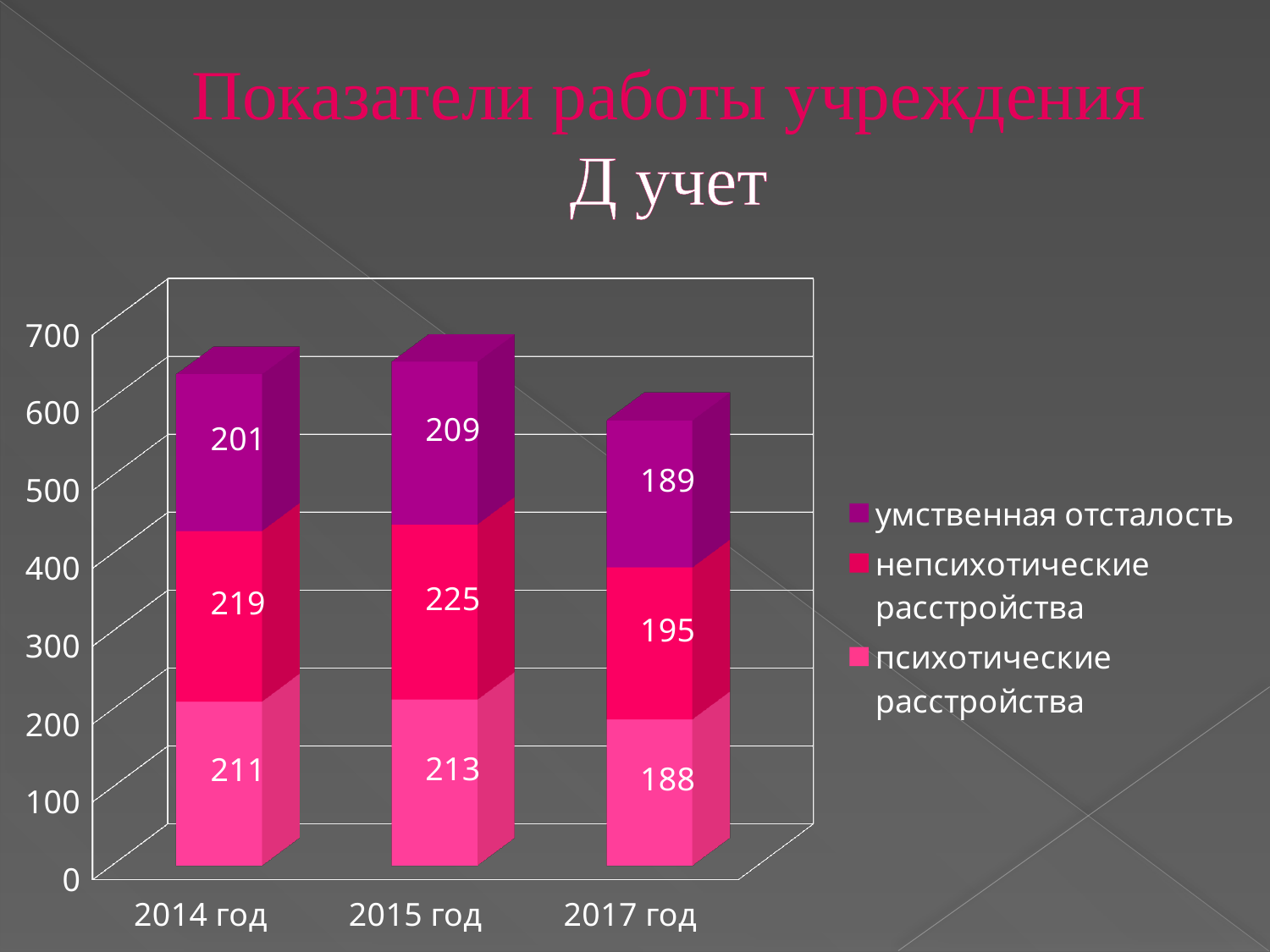
How many series does the legend list? 3 Which year has the highest value for непсихотические расстройства? 2015 год Which year has the lowest value for умственная отсталость? 2017 год What is the total of the stacked bar for 2015 год? 647 What is the total of the stacked bar for 2017 год? 572 What kind of chart is shown on the slide? Stacked bar chart What is the value for непсихотические расстройства in 2014 год? 219 What is the value for умственная отсталость in 2015 год? 209 Which is larger: психотические расстройства in 2014 год or in 2015 год? 2015 год What is the difference between the непсихотические расстройства values for 2015 год and 2017 год? 30 How many years are shown on the x axis? 3 What is the value for психотические расстройства in 2017 год? 188